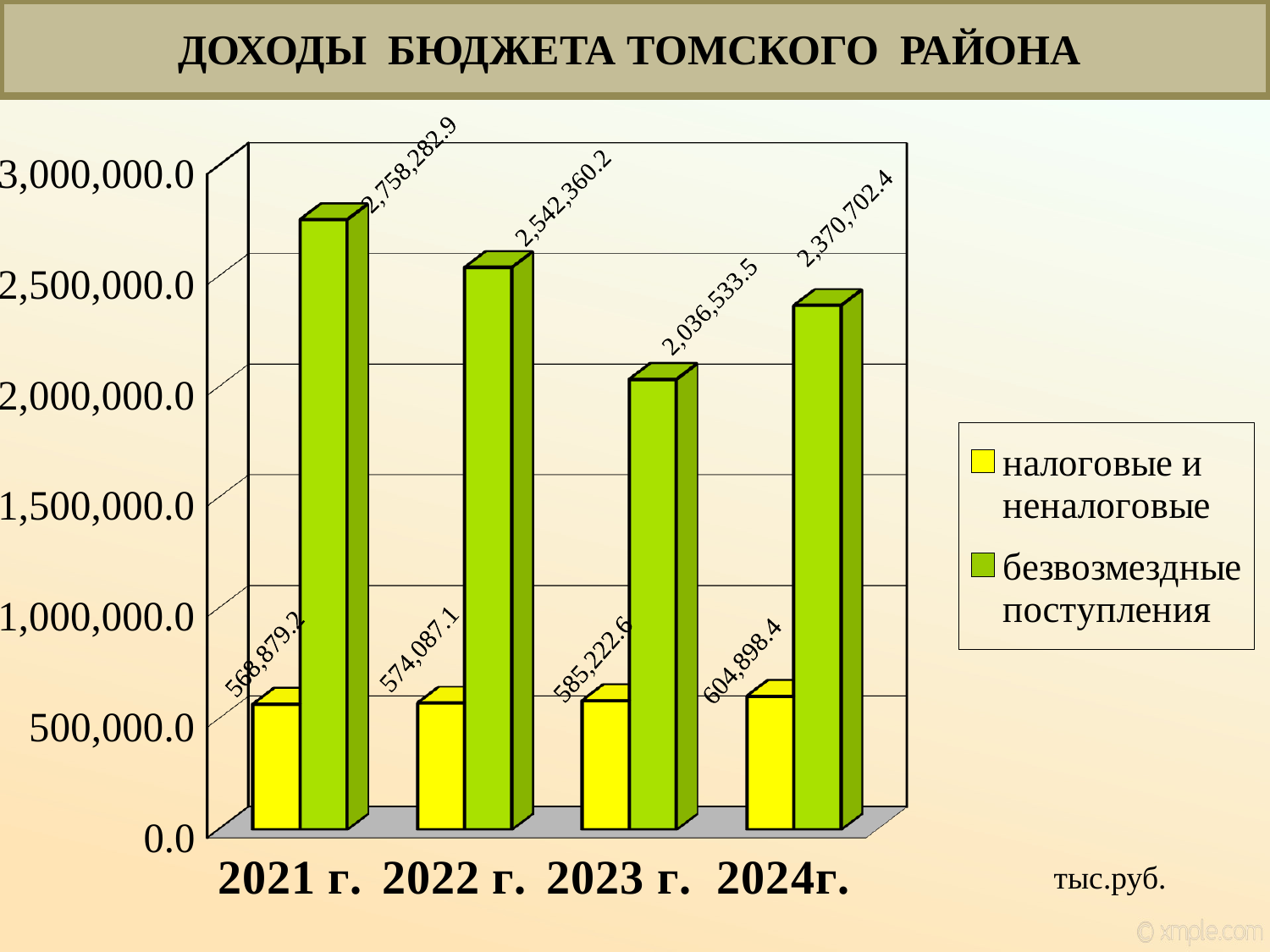
What is the value of безвозмездные поступления for 2021 г.? 2,758,282.9 How many series does the legend list? 2 In which year is безвозмездные поступления highest? 2021 г. Do the values of налоговые и неналоговые rise or fall from 2021 г. to 2024г.? rise What is the value of налоговые и неналоговые for 2024г.? 604,898.4 By how much did налоговые и неналоговые grow from 2021 г. to 2024г.? 36,019.2 What is the value of налоговые и неналоговые for 2022 г.? 574,087.1 In which year is безвозмездные поступления lowest? 2023 г. What is the value of безвозмездные поступления for 2023 г.? 2,036,533.5 What is the difference between безвозмездные поступления in 2021 г. and 2022 г.? 215,922.7 In which year is налоговые и неналоговые lowest? 2021 г. Which is larger: безвозмездные поступления in 2024г. or in 2023 г.? 2024г.